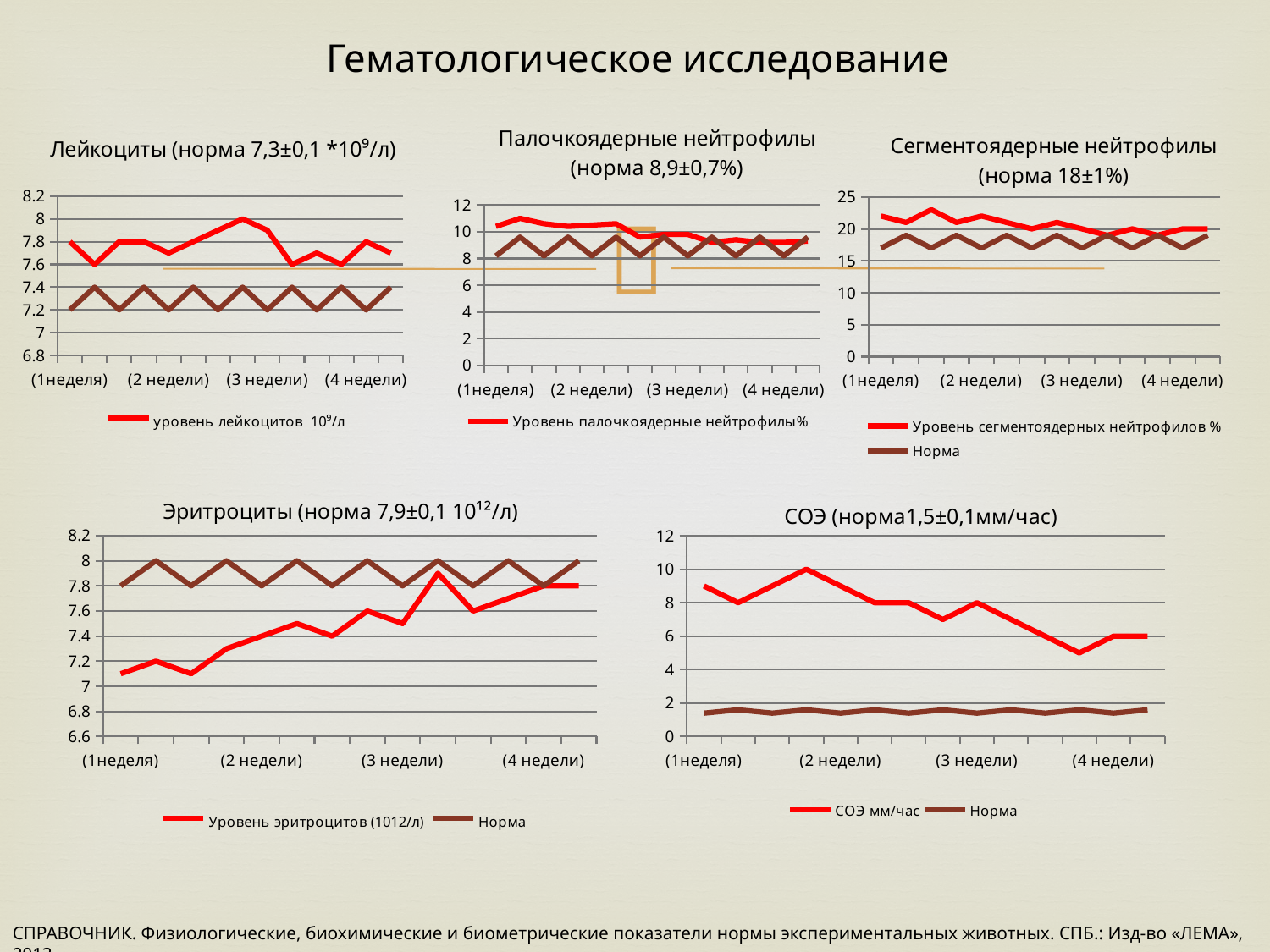
How many charts are shown on the slide? 5 What kind of chart is the Лейкоциты chart? line chart In the Палочкоядерные нейтрофилы chart, does the red line generally rise or fall from 1 неделя to 4 недели? fall In the СОЭ chart, what are the two legend entries? СОЭ мм/час and Норма In the Эритроциты chart, is the first value of the Уровень эритроцитов line greater or less than 7.2? less In the СОЭ chart, what is the highest value reached by the СОЭ мм/час line? 10 In the Сегментоядерные нейтрофилы chart, which line is higher at 1 неделя: Уровень сегментоядерных нейтрофилов or Норма? Уровень сегментоядерных нейтрофилов In the СОЭ chart, does the СОЭ мм/час line generally rise or fall from 1 неделя to 4 недели? fall In the Эритроциты chart, does the Уровень эритроцитов line generally rise or fall from 1 неделя to 4 недели? rise How many series does the legend of the Эритроциты chart list? 2 In the СОЭ chart, is the lowest value of the СОЭ мм/час line greater or less than 6? less In the Сегментоядерные нейтрофилы chart, is the first value of the red line greater or less than 20? greater